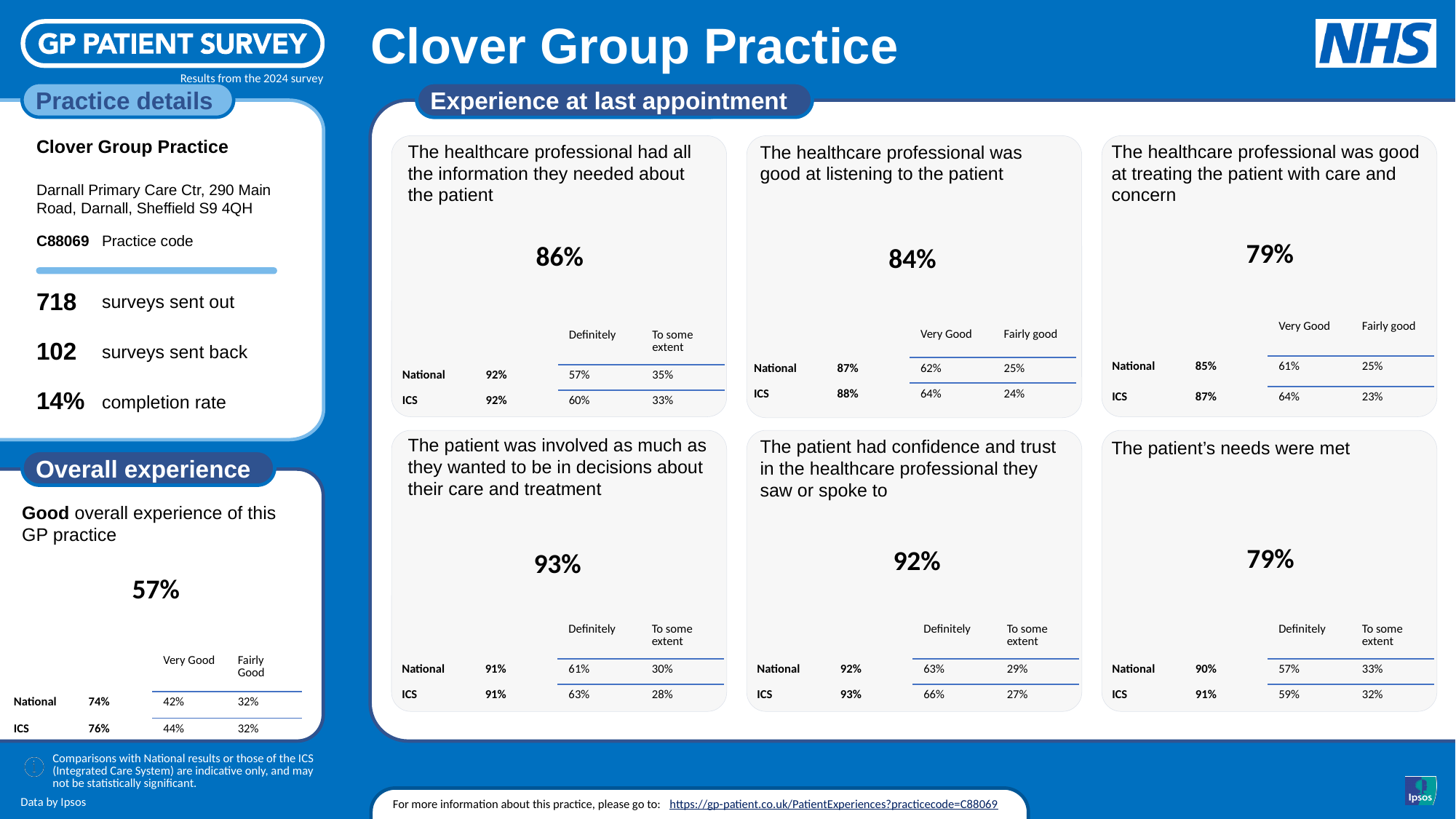
In the 'Experience at last appointment' section, what is the practice value for 'The patient was involved as much as they wanted to be in decisions about their care and treatment'? 93% In the 'Overall experience' panel, what is the ICS 'Very Good' value? 44% In the 'Overall experience' panel, what percentage of patients reported a good overall experience of this GP practice? 57% In the 'Overall experience' panel, what is the difference between the ICS value and the practice value for good overall experience? 19% In the panel 'The healthcare professional had all the information they needed about the patient', what is the difference between the ICS value and the practice value? 6% In the panel 'The patient had confidence and trust in the healthcare professional they saw or spoke to', which is larger, the National value or the ICS value? ICS In the panel 'The healthcare professional was good at treating the patient with care and concern', what is the ICS 'Fairly good' value? 23% In the 'Experience at last appointment' section, which measure has the highest practice value? The patient was involved as much as they wanted to be in decisions about their care and treatment In the panel 'The patient's needs were met', what is the National value? 90% How many measure panels are shown in the 'Experience at last appointment' section? 6 In the 'Overall experience' panel, what is the National value for good overall experience? 74% In the 'Experience at last appointment' section, what is the practice value for 'The healthcare professional was good at listening to the patient'? 84%